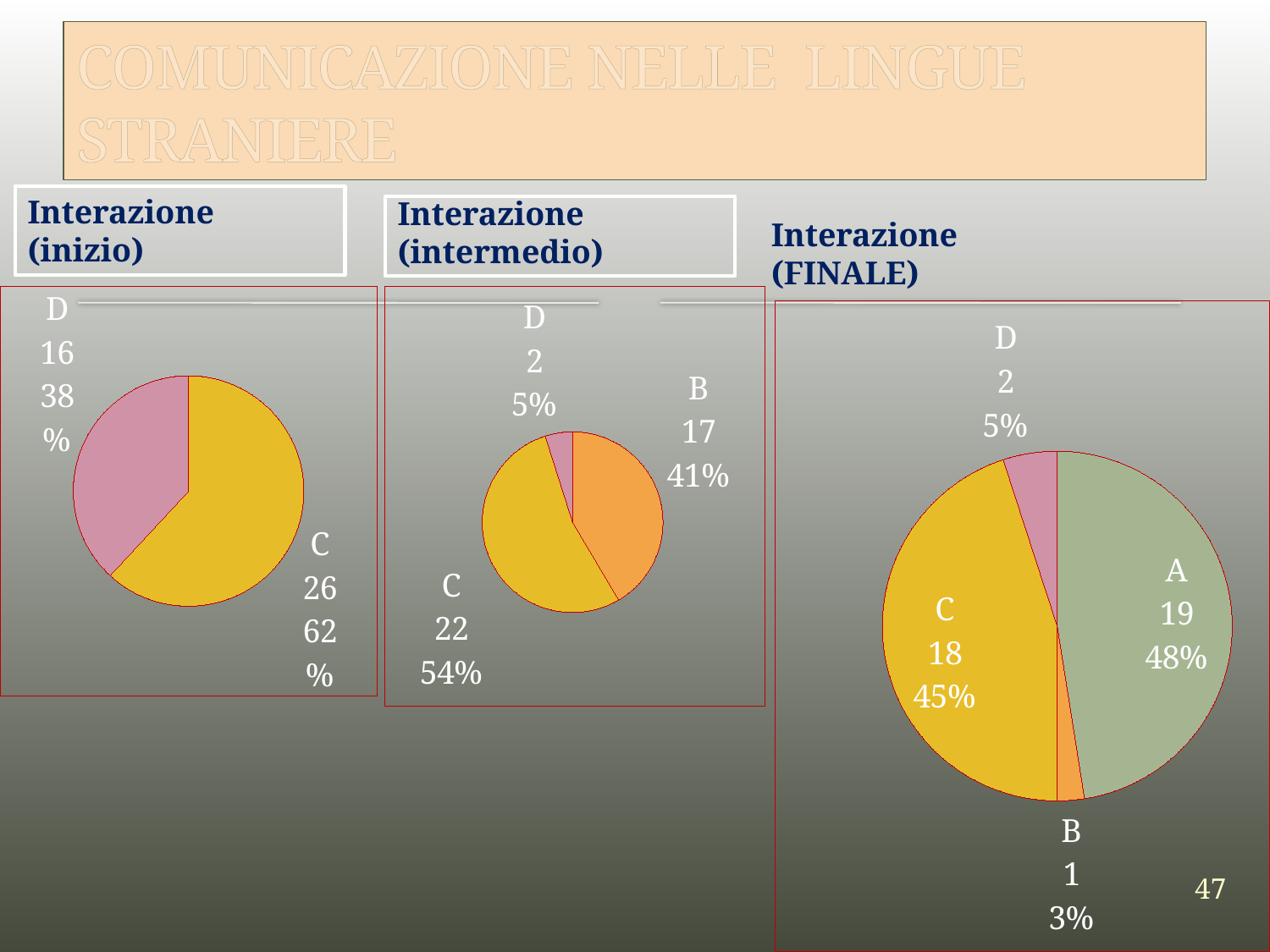
In the "Interazione (intermedio)" chart, what share of the pie does category D have? 5% In the "Interazione (intermedio)" chart, what is the value for category B? 17 In the "Interazione (FINALE)" chart, which is larger, the value for A or the value for C? A What kind of chart is used in the "Interazione (inizio)" chart? pie chart In the "Interazione (intermedio)" chart, which category has the largest slice? C In the "Interazione (inizio)" chart, what is the value for category C? 26 In the "Interazione (intermedio)" chart, what is the difference between the values for C and B? 5 In the "Interazione (FINALE)" chart, which category has the smallest slice? B How many slices does the "Interazione (inizio)" pie chart have? 2 In the "Interazione (inizio)" chart, what share of the pie does category D have? 38% In the "Interazione (FINALE)" chart, what share of the pie does category A have? 48% How many slices does the "Interazione (FINALE)" pie chart have? 4